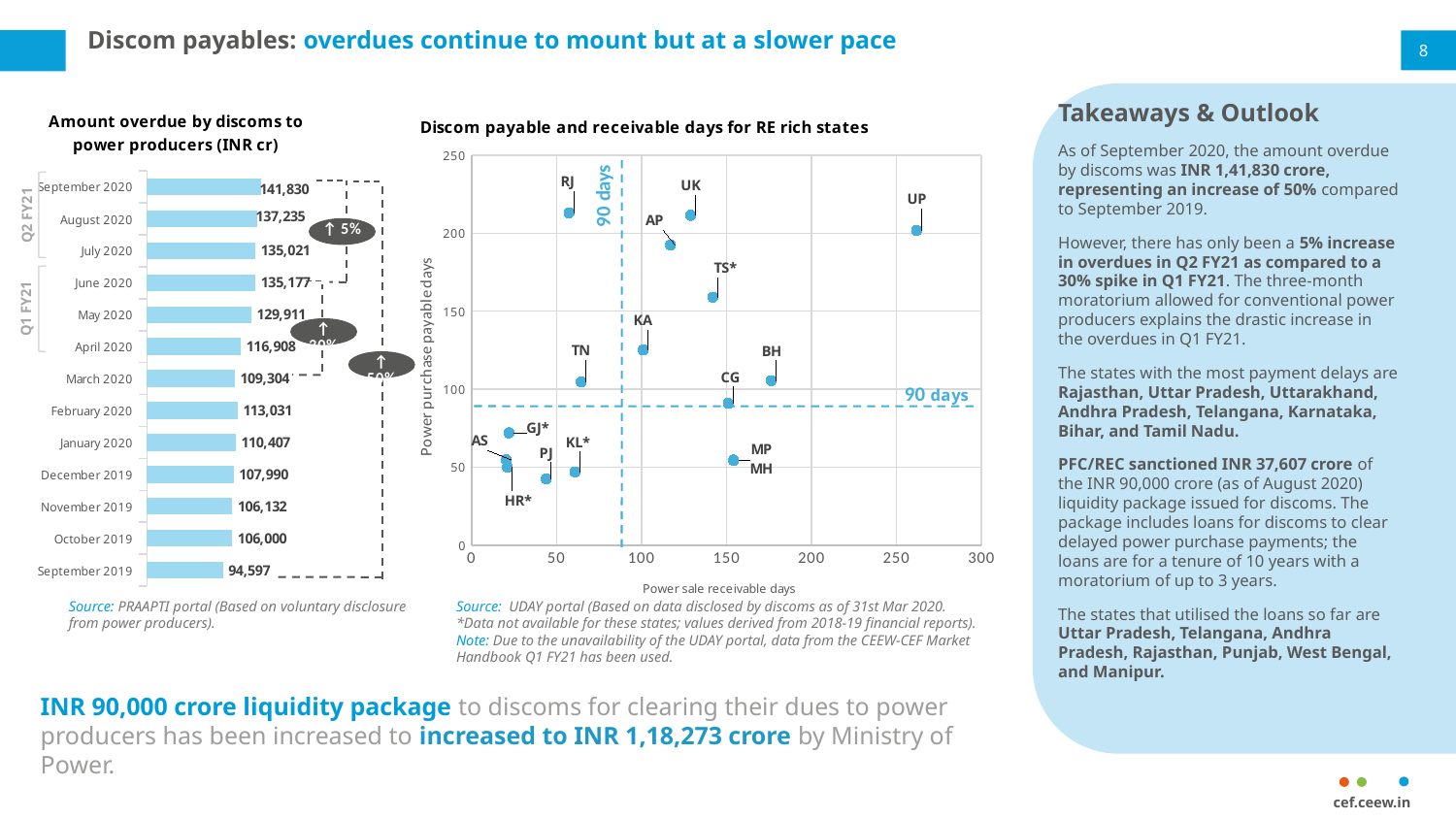
What kind of chart is 'Amount overdue by discoms to power producers (INR cr)'? Bar chart On the 'Amount overdue by discoms to power producers (INR cr)' chart, which month has the lowest amount overdue? September 2019 On the 'Amount overdue by discoms to power producers (INR cr)' chart, what is the value for September 2020? 141,830 On the 'Amount overdue by discoms to power producers (INR cr)' chart, which is larger, the value for February 2020 or March 2020? February 2020 On the 'Discom payable and receivable days for RE rich states' chart, is the power sale receivable days value for UP greater or less than 200? greater What kind of chart is 'Discom payable and receivable days for RE rich states'? Scatter chart On the 'Amount overdue by discoms to power producers (INR cr)' chart, what is the value for April 2020? 116,908 On the 'Discom payable and receivable days for RE rich states' chart, is the power purchase payable days value for HR* greater or less than 50? less How many months are shown on the 'Amount overdue by discoms to power producers (INR cr)' chart? 13 On the 'Amount overdue by discoms to power producers (INR cr)' chart, what is the difference between the September 2020 and August 2020 values? 4,595 On the 'Amount overdue by discoms to power producers (INR cr)' chart, which month has the highest amount overdue? September 2020 On the 'Discom payable and receivable days for RE rich states' chart, which state has the highest power sale receivable days? UP